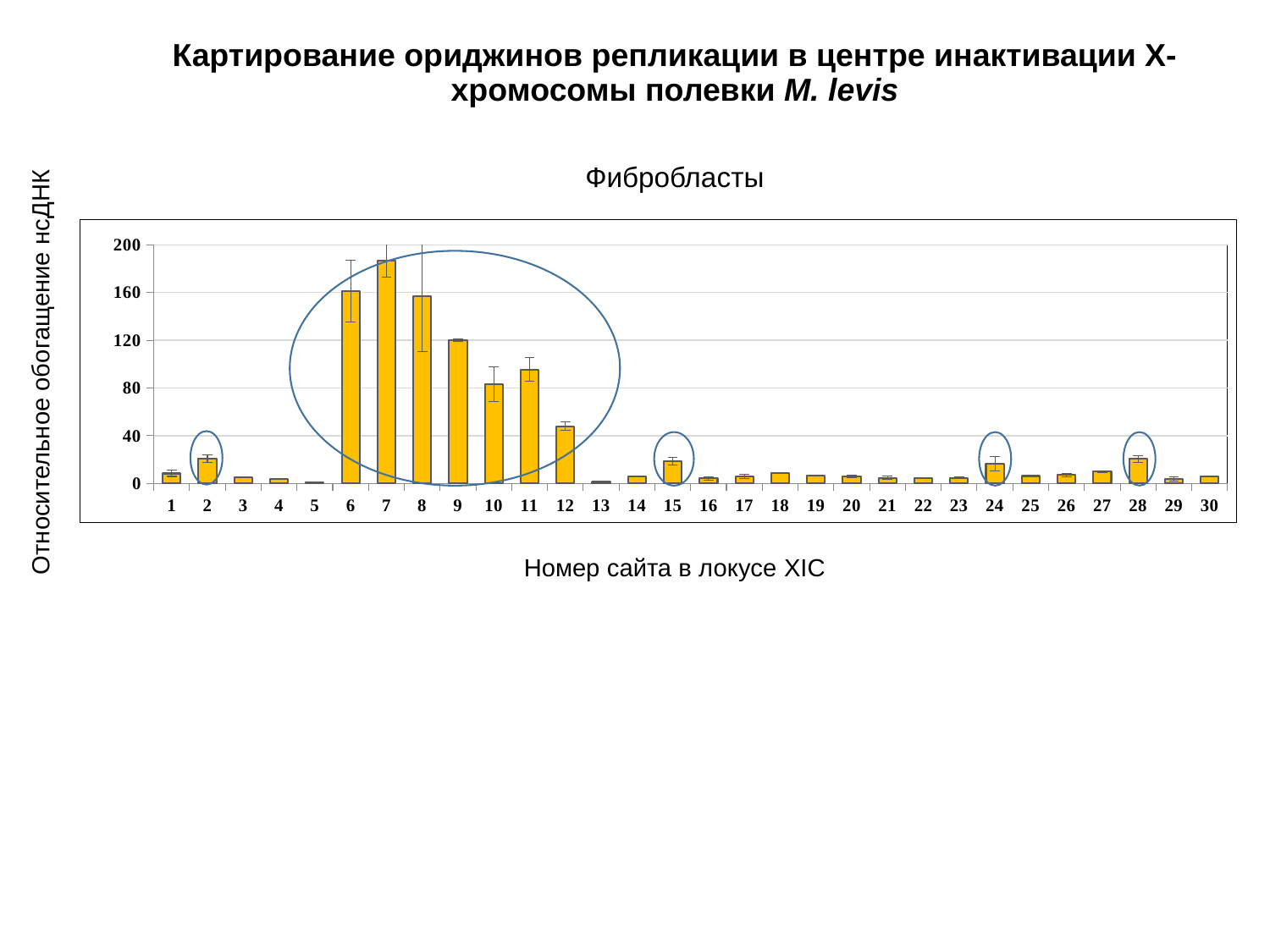
What kind of chart is shown on the slide? bar chart Is the value for site 10 greater or less than 120? less Is the value for site 11 greater or less than 80? greater Which is larger, the value for site 6 or the value for site 12? site 6 Which is larger, the value for site 7 or the value for site 9? site 7 Do the values rise or fall from site 7 to site 12? fall overall, with a rise from site 10 to site 11 Which site has the highest relative enrichment? 7 Is the value for site 2 greater or less than 40? less What is the title shown above the chart? Фибробласты How many sites (categories) are plotted along the x axis? 30